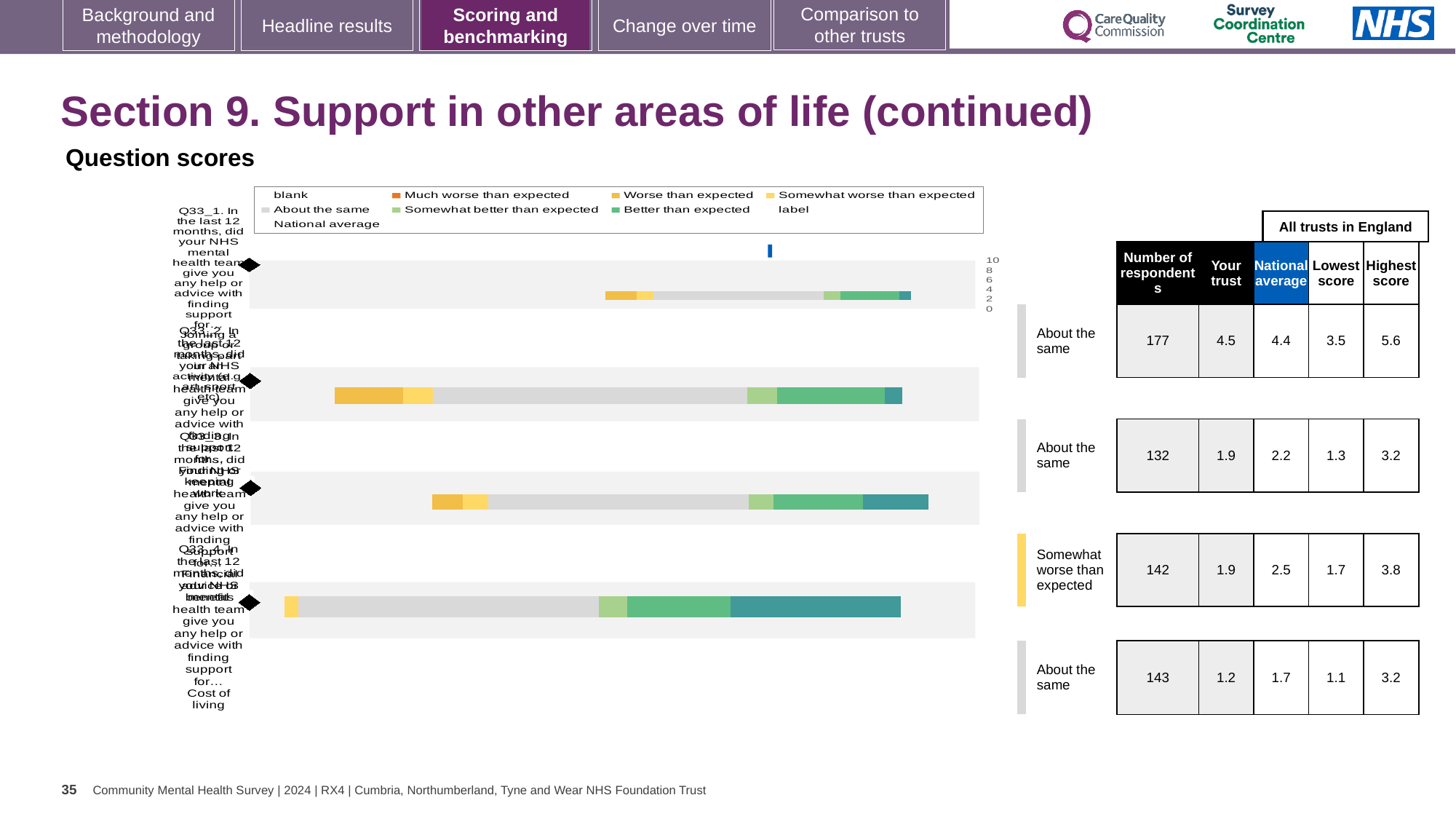
Which question row has the highest 'Your trust' score in the table? Q33_1 In the table beside the chart, what is the 'Your trust' score for the fourth question (Q33_4, Cost of living)? 1.2 How many entries does the chart legend list? 9 In the table beside the chart, what is the number of respondents for the first question (Q33_1)? 177 How many question bars are plotted in the chart? 4 What benchmark label is shown next to the third bar (Q33_3)? Somewhat worse than expected What kind of chart is shown under 'Question scores'? Bar chart Which question row has the lowest number of respondents in the table? Q33_2 For the first question (Q33_1), is the 'Your trust' score or the national average larger? Your trust Which legend entry is shown in dark orange? Much worse than expected In the table beside the chart, what is the national average for the third question (Q33_3)? 2.5 For the third question (Q33_3), what is the difference between the national average and the 'Your trust' score? 0.6